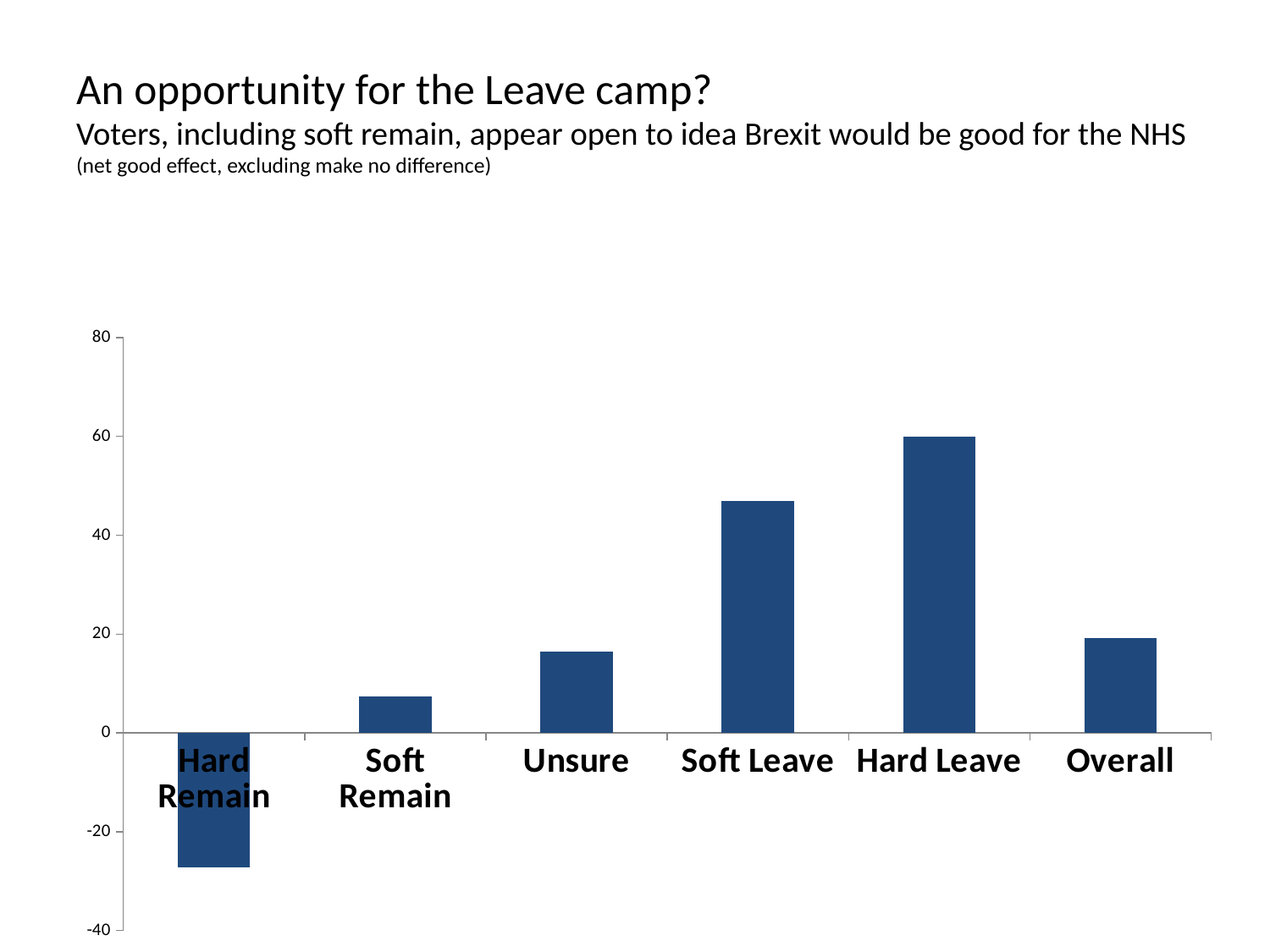
Is the value for Soft Leave greater or less than 40? greater Which category has the lowest value in the chart? Hard Remain Which category has the highest value in the chart? Hard Leave What is the title of the slide containing the chart? An opportunity for the Leave camp? Which is larger, the value for Soft Leave or the value for Overall? Soft Leave Is the value for Unsure greater or less than 20? less Which category is the only one with a negative value? Hard Remain What kind of chart is shown on the slide? bar chart Is the value for Soft Remain greater or less than 20? less How many categories are shown on the x axis of the chart? 6 Which is larger, the value for Unsure or the value for Soft Remain? Unsure